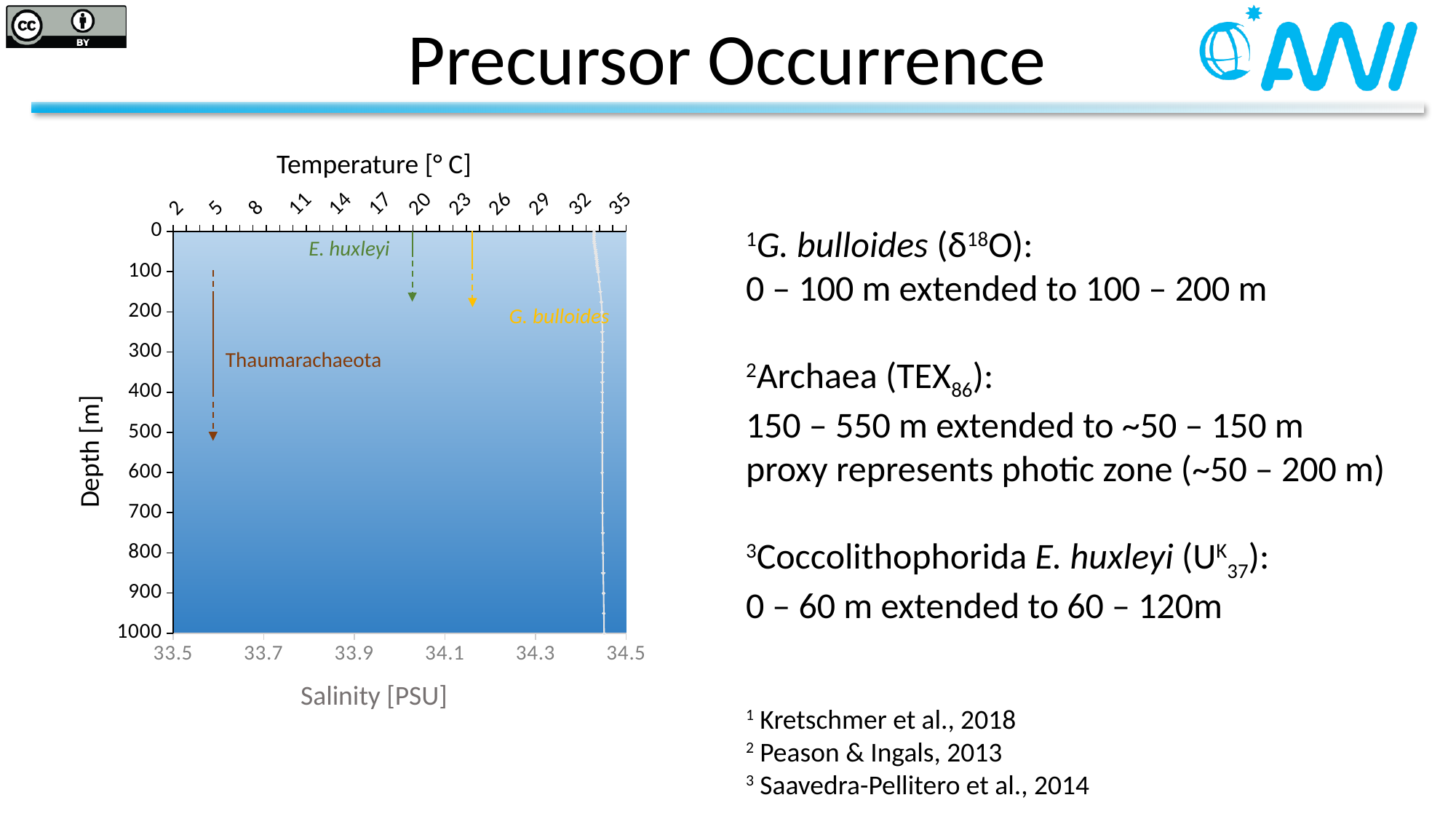
Is the maximum depth of the E. huxleyi arrow greater or less than 300 m? less What is the highest temperature value shown on the top axis? 35 What is the deepest value shown on the depth axis? 1000 Which annotated organism's arrow extends to the greatest depth? Thaumarachaeota Which arrow starts at a greater depth, Thaumarachaeota or E. huxleyi? Thaumarachaeota What is the label of the top horizontal axis on the chart? Temperature [° C] Is the salinity of the plotted profile at 1000 m depth greater or less than 34.3 PSU? greater Is the maximum depth of the G. bulloides arrow greater or less than 400 m? less What is the label of the vertical axis on the chart? Depth [m] How many organisms are annotated with depth-range arrows on the chart? 3 What is the highest salinity value shown on the bottom axis? 34.5